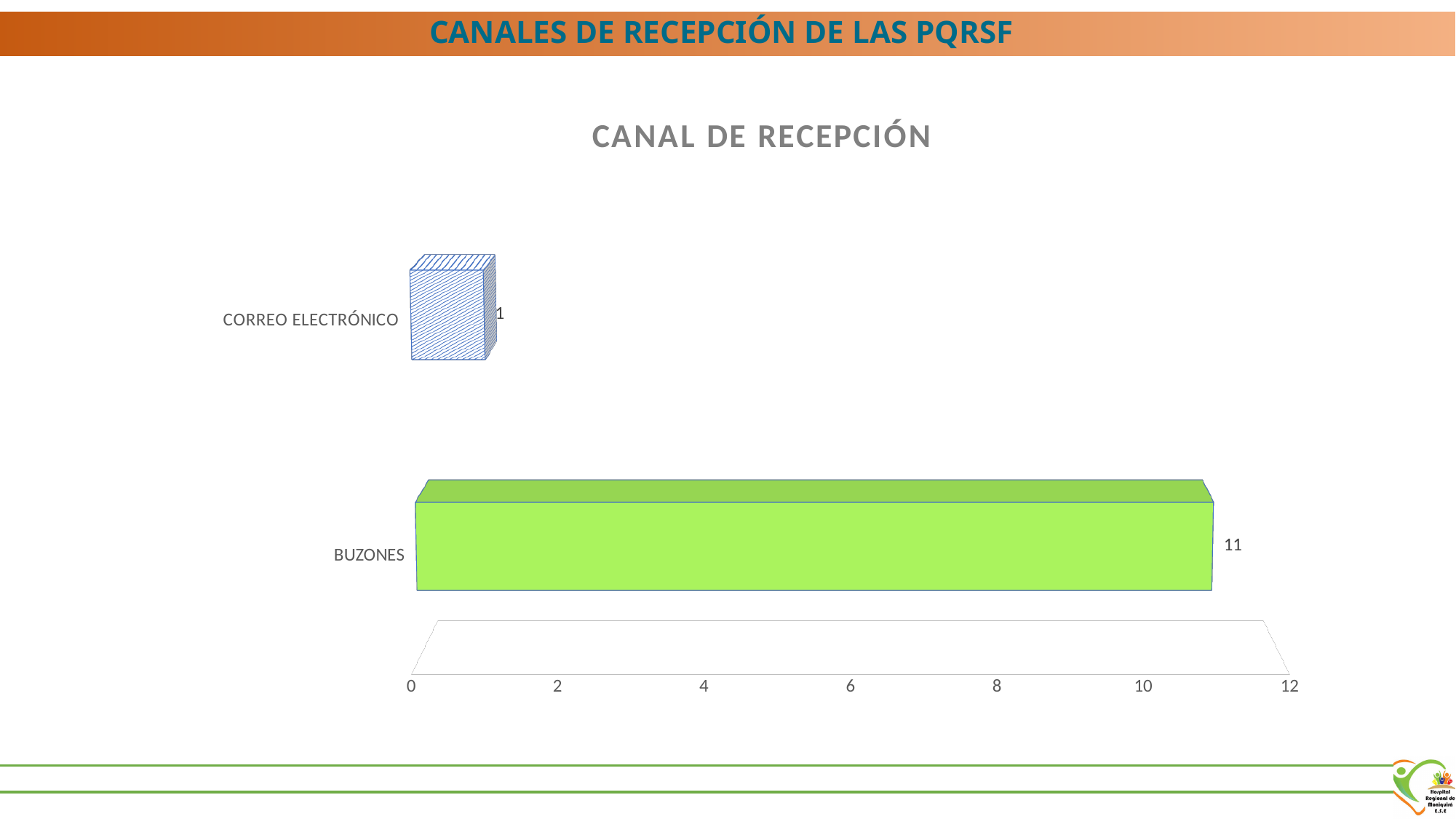
How many categories are shown in the chart? 2 What is the title of the chart? CANAL DE RECEPCIÓN Which category has the highest value? BUZONES Which is larger, the value for BUZONES or the value for CORREO ELECTRÓNICO? BUZONES Which category has the lowest value? CORREO ELECTRÓNICO Is the value for CORREO ELECTRÓNICO greater or less than 2? less What is the maximum value shown on the horizontal axis? 12 What is the value for CORREO ELECTRÓNICO? 1 What kind of chart is shown on the slide? bar chart What is the difference between the values for BUZONES and CORREO ELECTRÓNICO? 10 Is the value for BUZONES greater or less than 10? greater What is the value for BUZONES? 11